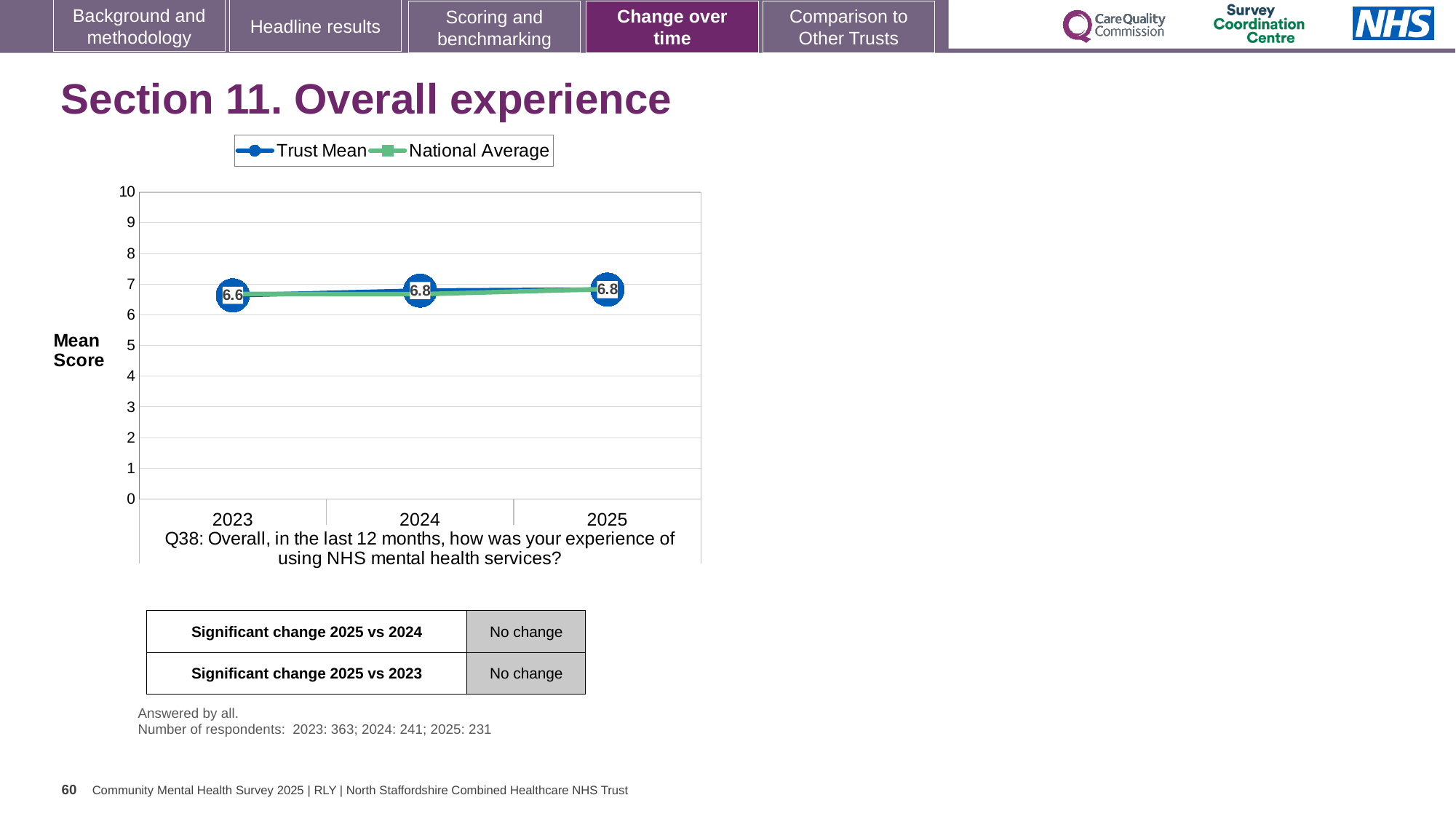
Is the National Average value for 2025 greater or less than 8? less What kind of chart is shown on the slide? Line chart How many years are shown on the x axis of the chart? 3 Which is larger, the Trust Mean score for 2023 or for 2025? 2025 What is the Trust Mean score for 2024? 6.8 What is the Trust Mean score for 2023? 6.6 In which year is the Trust Mean score lowest? 2023 What is the Trust Mean score for 2025? 6.8 How many series does the chart legend list? 2 What is the label on the y axis of the chart? Mean Score Is the Trust Mean score for 2023 greater or less than 5? greater What is the difference between the Trust Mean score in 2024 and in 2023? 0.2